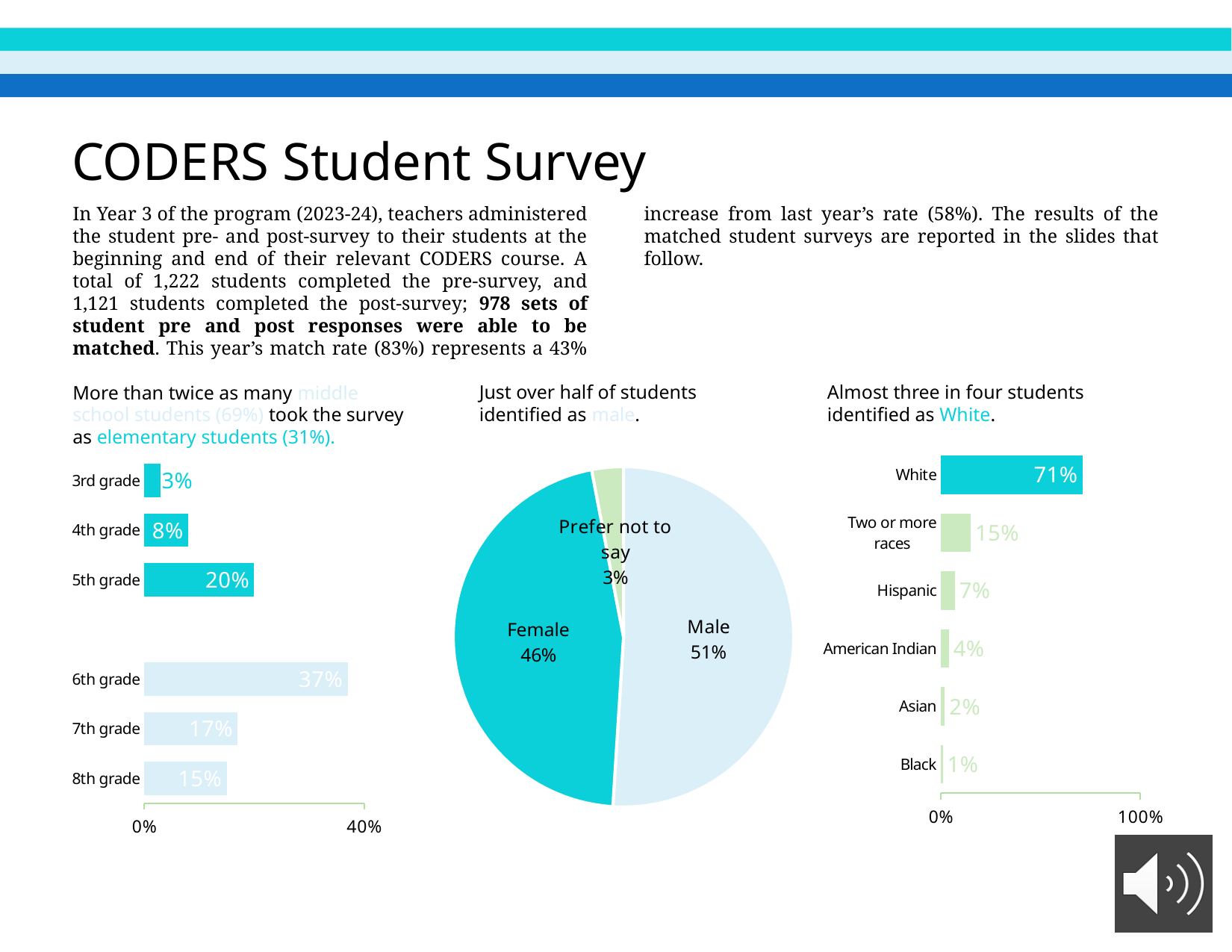
In the left bar chart of grade levels, how many grade categories are shown? 6 In the right bar chart of race/ethnicity, what percentage of students identified as Hispanic? 7% In the left bar chart of grade levels, what percentage of students were in 6th grade? 37% In the left bar chart of grade levels, which grade has the lowest percentage? 3rd grade In the left bar chart of grade levels, which grade has the highest percentage? 6th grade In the right bar chart of race/ethnicity, is the value for Two or more races larger or smaller than the value for American Indian? Larger In the middle pie chart of gender, what share of students identified as Female? 46% In the left bar chart of grade levels, what is the difference between the 5th grade and 4th grade percentages? 12% In the right bar chart of race/ethnicity, which category has the lowest percentage? Black In the middle pie chart of gender, how many slices are there? 3 In the middle pie chart of gender, which slice is the largest? Male What kind of chart is the middle chart showing gender? Pie chart